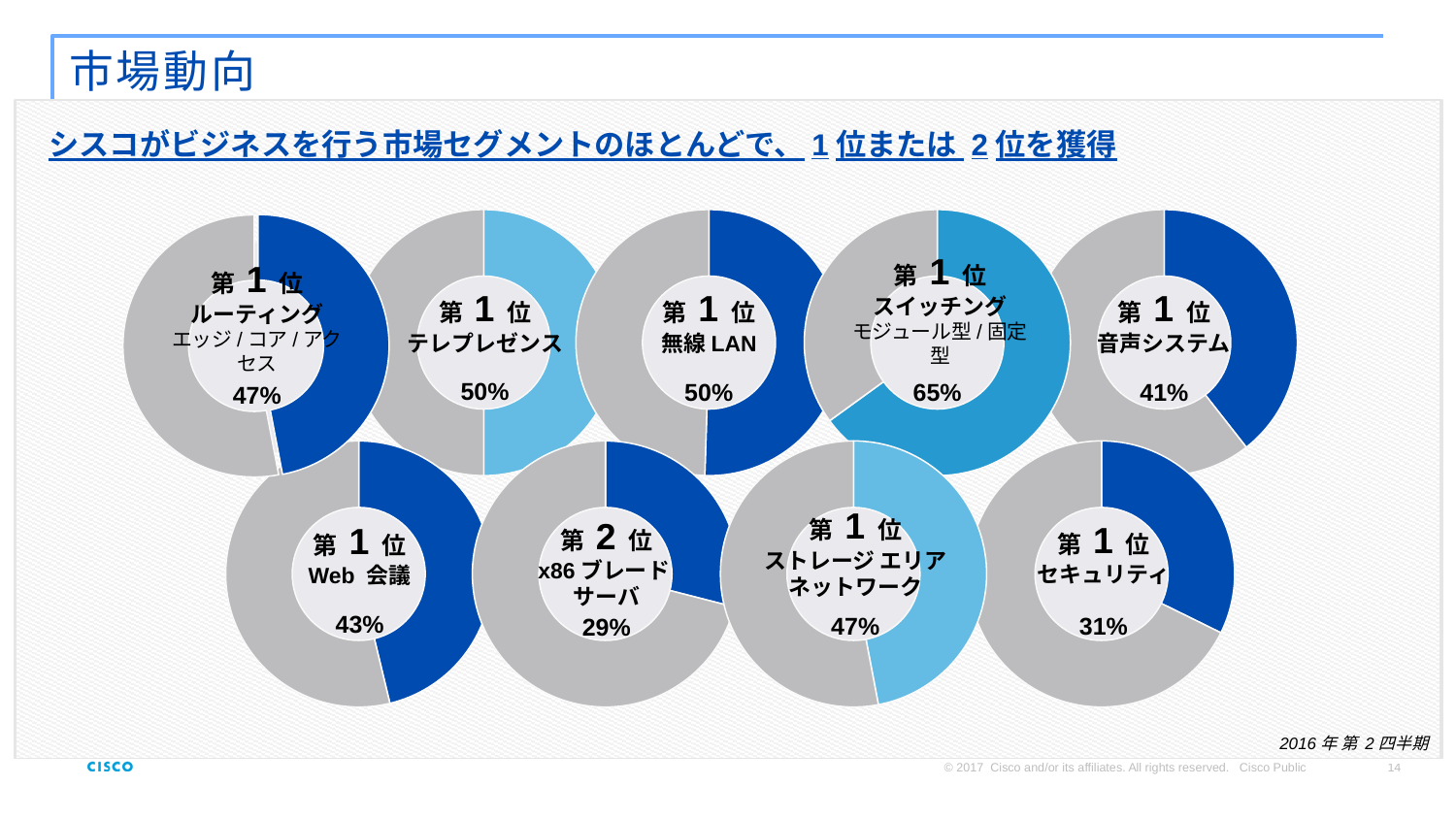
In the セキュリティ donut chart, what market share percentage is shown? 31% In the 音声システム donut chart, what market share percentage is shown? 41% In the スイッチング donut chart, what market share percentage is shown? 65% Which market segment on the slide is labeled 第 2 位 rather than 第 1 位? x86 ブレード サーバ What kind of chart is used for each market segment on the slide? Donut (pie) chart Across all the donut charts on the slide, which market segment shows the highest share percentage? スイッチング What is the difference between the share shown in the スイッチング chart and the share shown in the ルーティング chart? 18% What is the difference between the share shown in the 無線 LAN chart and the share shown in the x86 ブレード サーバ chart? 21% Which shows a larger share: the Web 会議 chart or the セキュリティ chart? Web 会議 Across all the donut charts on the slide, which market segment shows the lowest share percentage? x86 ブレード サーバ How many donut charts are shown on the slide? 9 In the x86 ブレード サーバ donut chart, what market share percentage is shown? 29%